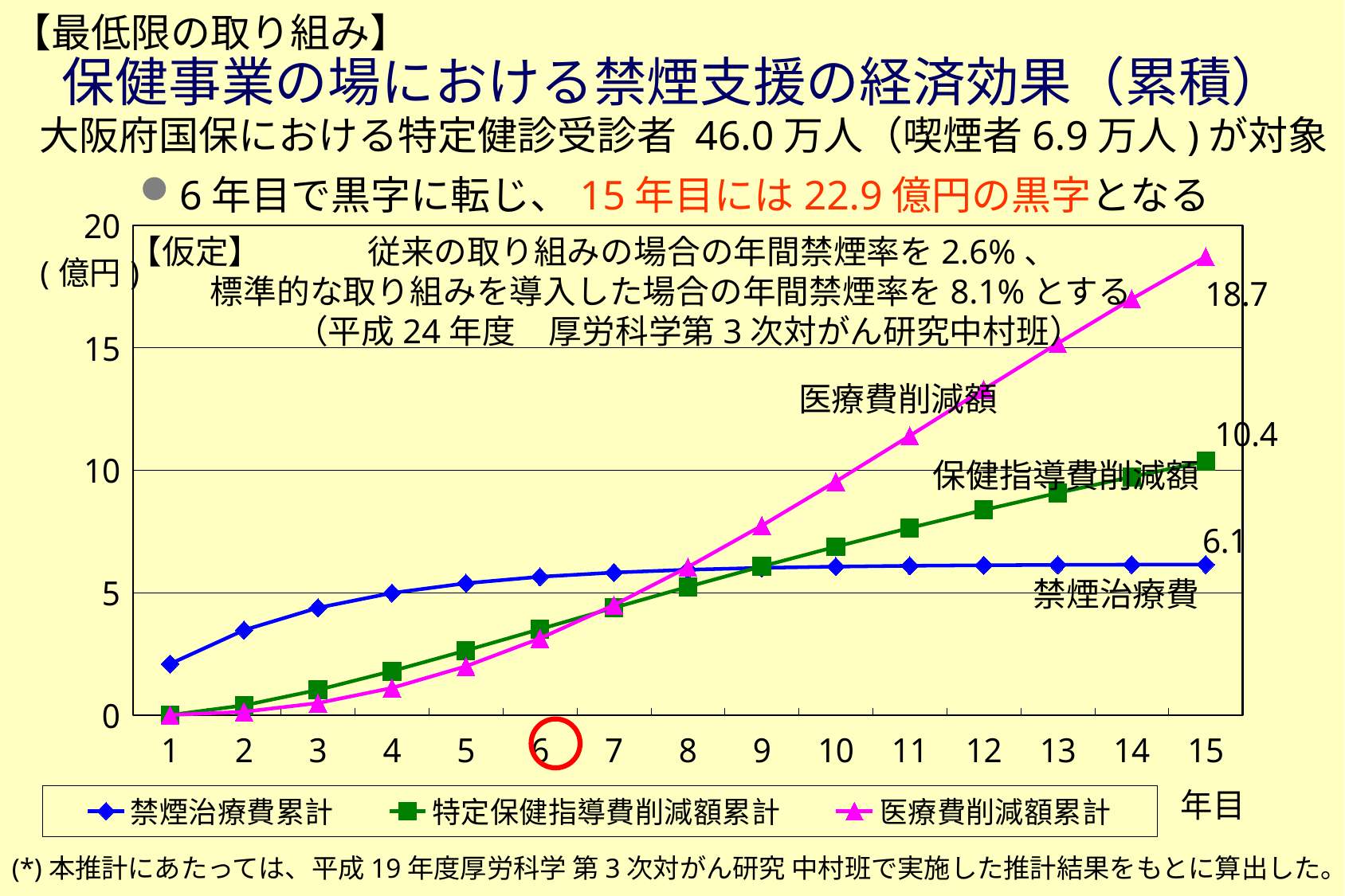
What is the value of 禁煙治療費累計 at year 15? 6.1 What kind of chart is shown on the slide? line chart Is the value for 禁煙治療費累計 at year 3 greater or less than 5? less Which series has the highest value at year 15? 医療費削減額累計 At year 1, which is larger: 禁煙治療費累計 or 医療費削減額累計? 禁煙治療費累計 Which series has the lowest value at year 15? 禁煙治療費累計 How many years are plotted on the x axis? 15 How many series does the legend list? 3 What is the value of 医療費削減額累計 at year 15? 18.7 What is the value of 特定保健指導費削減額累計 at year 15? 10.4 What is the difference between 医療費削減額累計 and 禁煙治療費累計 at year 15? 12.6 What is the difference between 医療費削減額累計 and 特定保健指導費削減額累計 at year 15? 8.3